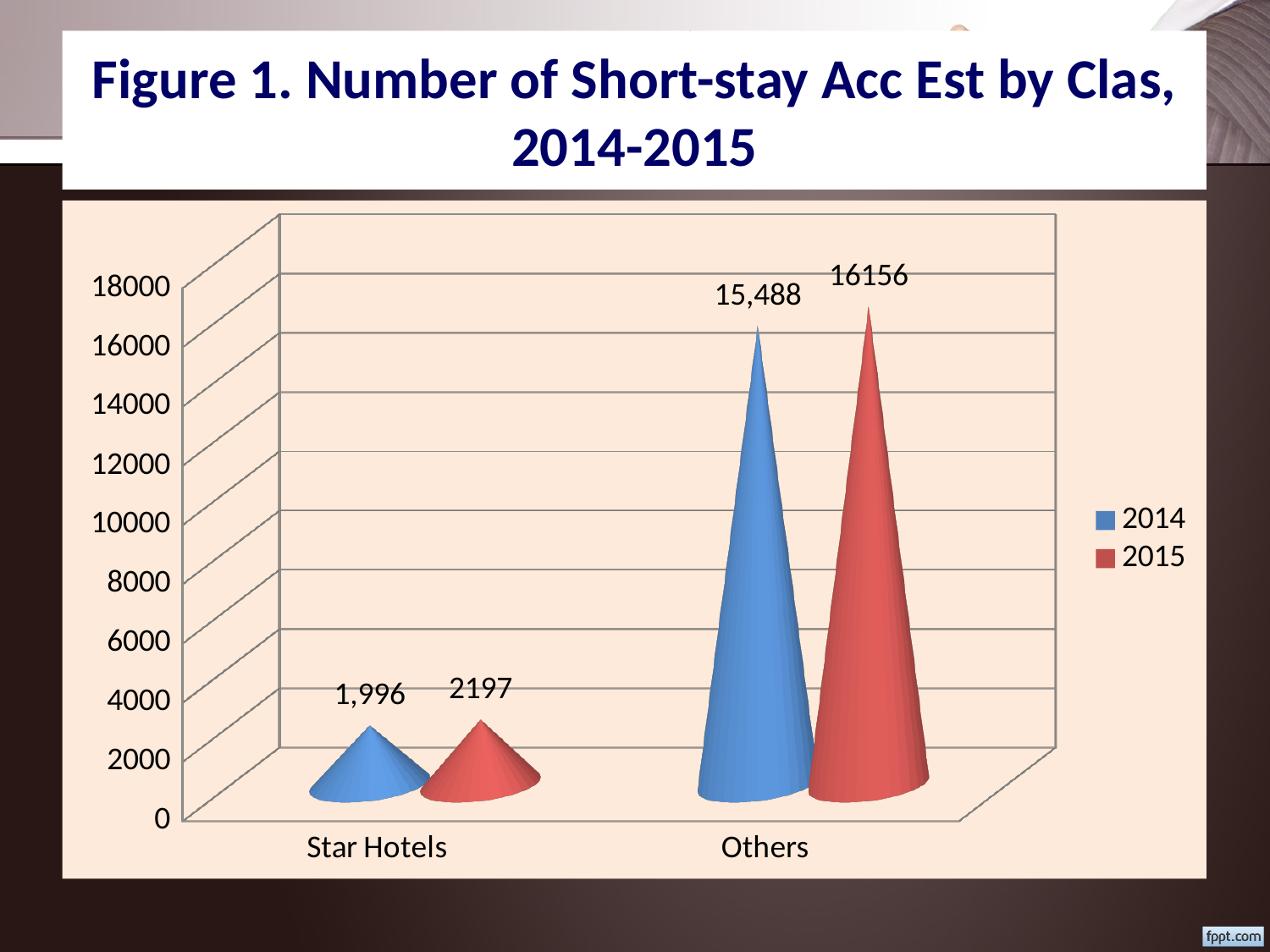
Which is larger for Others: the 2014 value or the 2015 value? 2015 What is the difference between the 2015 and 2014 values for Star Hotels? 201 How many series does the legend list? 2 What is the value for Star Hotels in 2015? 2197 What is the difference between the 2015 and 2014 values for Others? 668 What kind of chart is shown on the slide? Bar chart What is the value for Star Hotels in 2014? 1,996 Which category has the highest value in 2015? Others What is the value for Others in 2014? 15,488 Which category has the lowest value in 2014? Star Hotels How many categories are shown on the x axis? 2 What is the value for Others in 2015? 16156